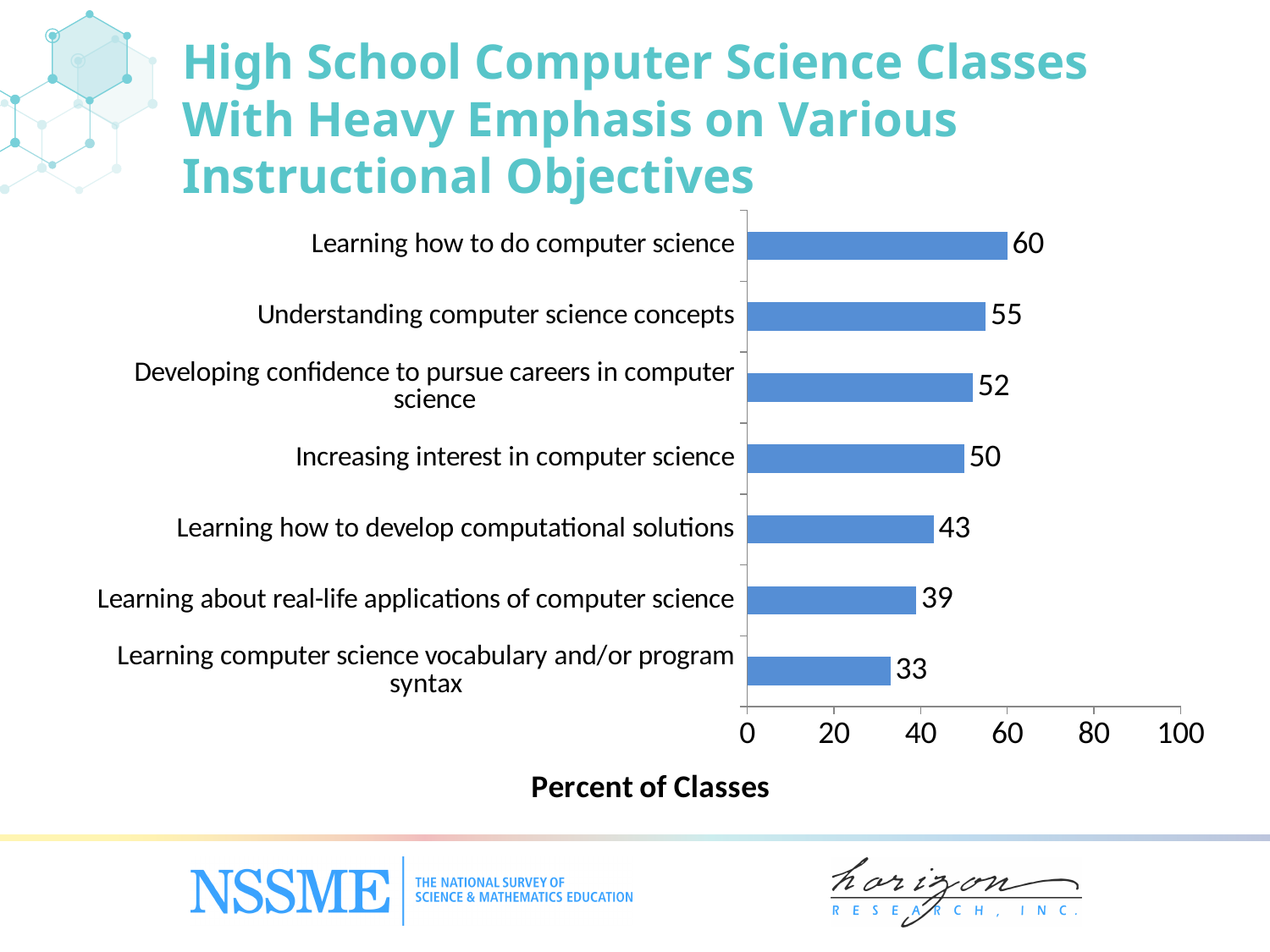
Which is larger: the value for 'Developing confidence to pursue careers in computer science' or 'Learning how to develop computational solutions'? Developing confidence to pursue careers in computer science What is the label of the horizontal axis? Percent of Classes Is the value for 'Learning about real-life applications of computer science' greater or less than 40? less How many instructional objectives are shown in the chart? 7 What is the value for 'Learning computer science vocabulary and/or program syntax'? 33 What percent of classes place heavy emphasis on learning how to do computer science? 60 Which instructional objective has the highest percent of classes? Learning how to do computer science Which instructional objective has the lowest percent of classes? Learning computer science vocabulary and/or program syntax What is the value for 'Increasing interest in computer science'? 50 What is the maximum value shown on the horizontal axis? 100 What kind of chart is shown on the slide? bar chart What is the difference between the values for 'Understanding computer science concepts' and 'Learning about real-life applications of computer science'? 16